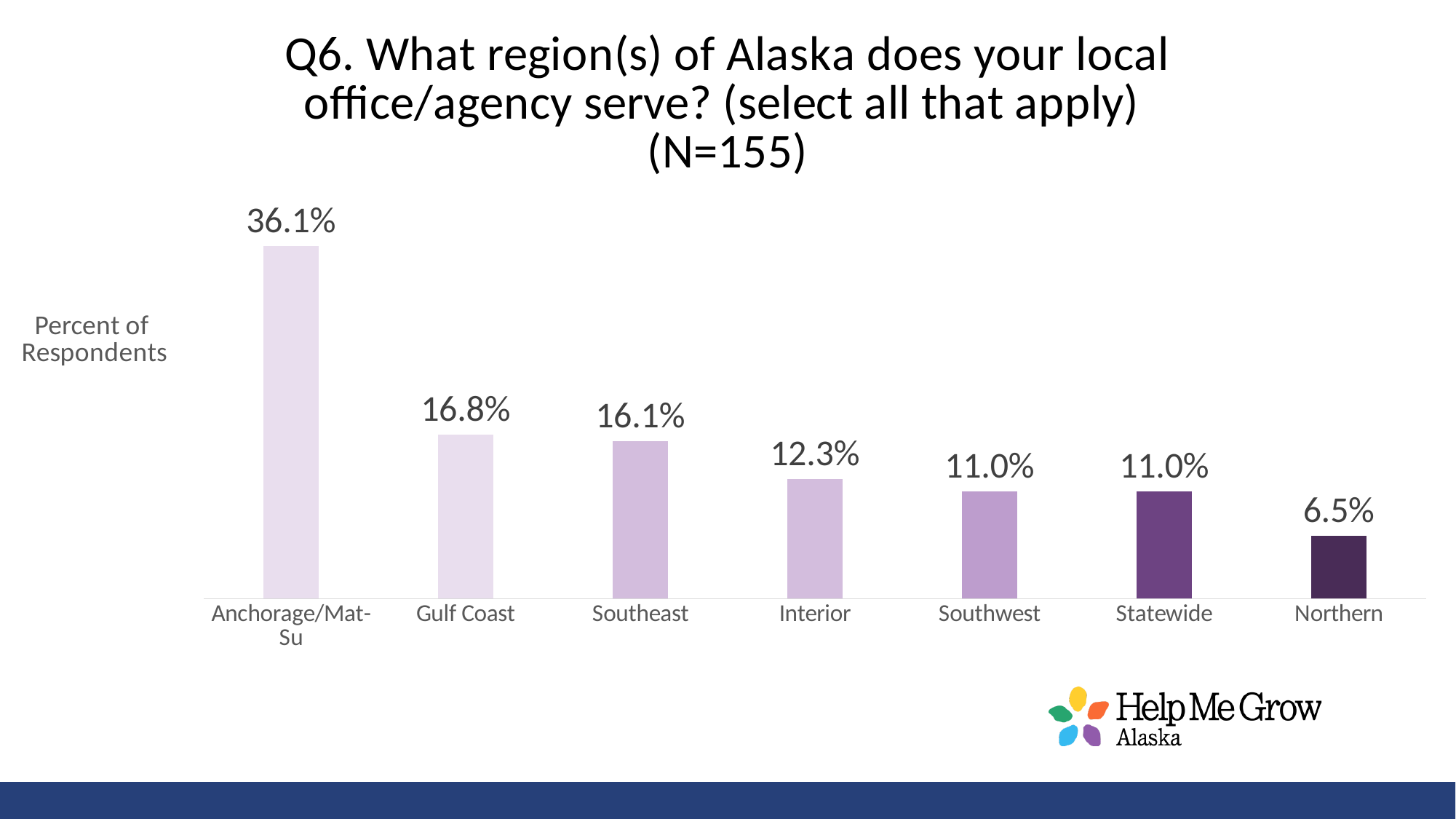
Which has a higher percent of respondents, Southeast or Interior? Southeast What percent of respondents is shown for Interior? 12.3% What percent of respondents is shown for Gulf Coast? 16.8% What percent of respondents is shown for Anchorage/Mat-Su? 36.1% What is the difference in percent of respondents between Southeast and Northern? 9.6% What is the sample size (N) given in the chart title? 155 Which region has the highest percent of respondents? Anchorage/Mat-Su Which region has the lowest percent of respondents? Northern What percent of respondents is shown for Northern? 6.5% What kind of chart is shown on the slide? Bar chart What is the difference in percent of respondents between Anchorage/Mat-Su and Gulf Coast? 19.3% How many regions are shown on the x axis? 7